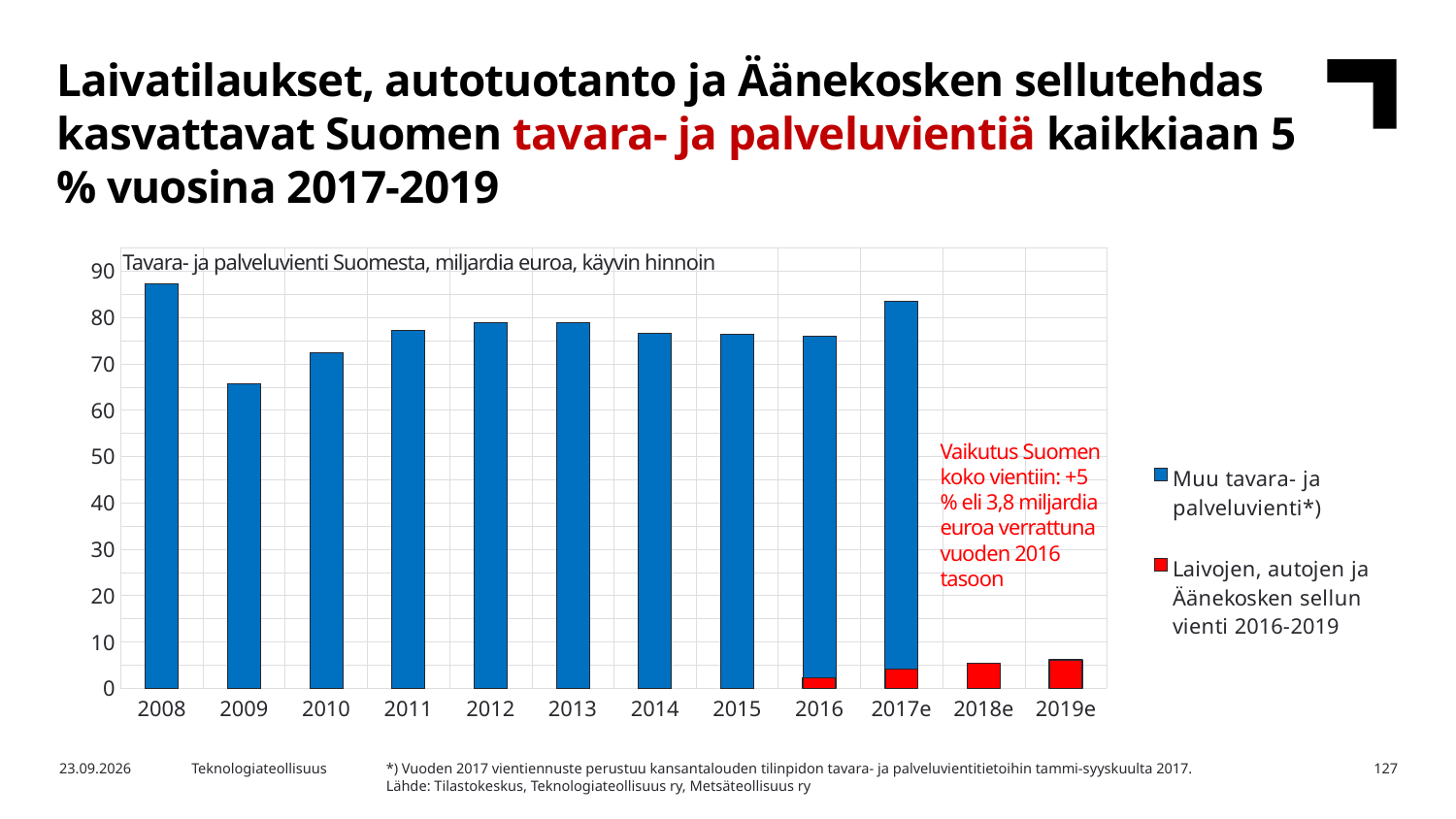
Is the total value for 2008 greater or less than 80? greater Which year has the larger total bar, 2016 or 2017e? 2017e How many series does the chart legend list? 2 Which year has the lowest value for the 'Muu tavara- ja palveluvienti*)' series among the years where it is plotted? 2009 What is the title of the chart? Tavara- ja palveluvienti Suomesta, miljardia euroa, käyvin hinnoin What kind of chart is shown on the slide? Bar chart Which year has the highest total bar in the chart? 2008 Is the value of the red series 'Laivojen, autojen ja Äänekosken sellun vienti 2016-2019' for 2016 greater or less than 10? less How many years are shown on the x axis of the chart? 12 Is the value for 2009 greater or less than 70? less Does the total value rise or fall from 2008 to 2009? Fall